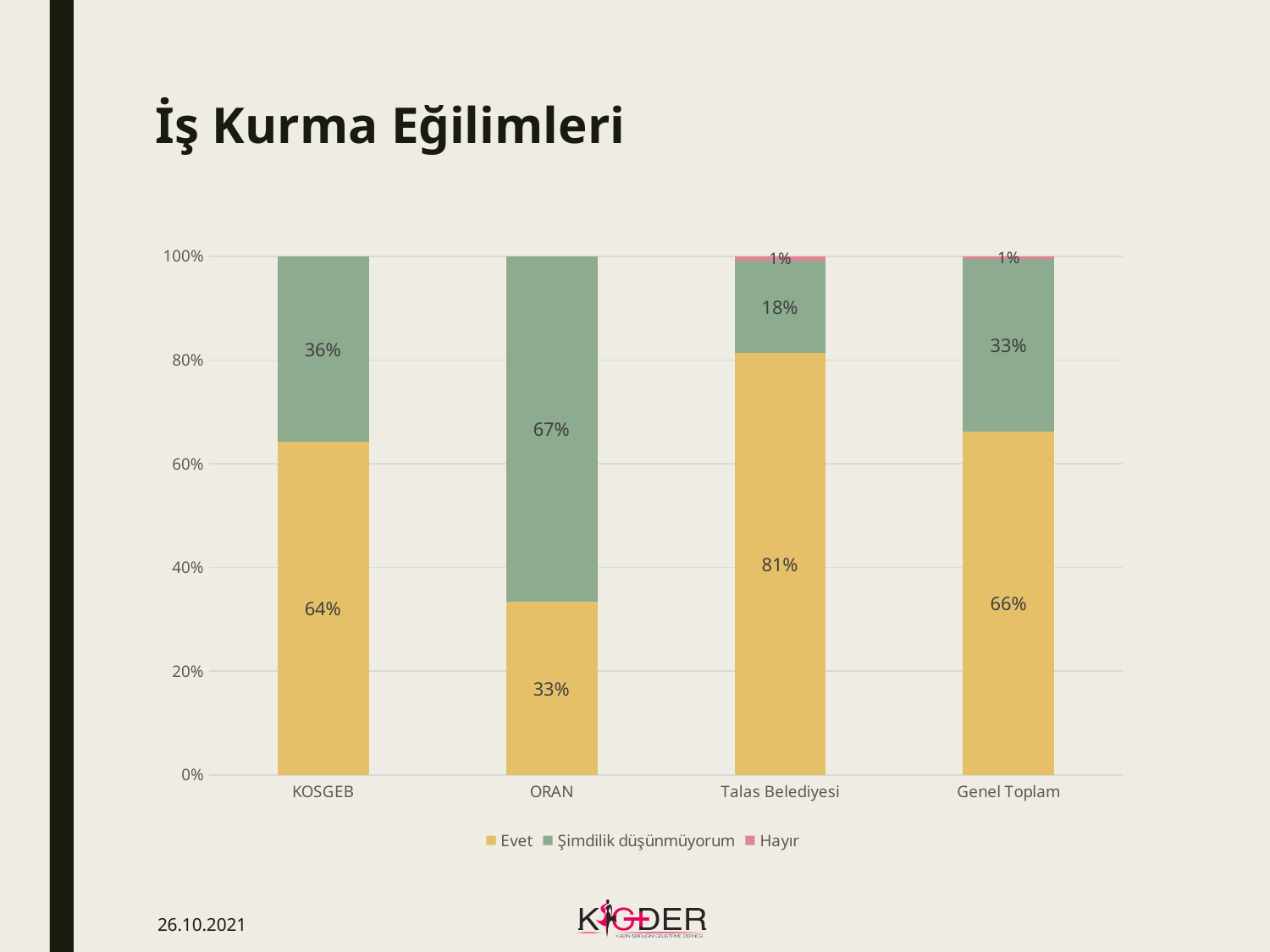
What kind of chart is shown on the slide? Stacked bar chart How many series does the legend list? 3 What is the Şimdilik düşünmüyorum value for ORAN? 67% Which is larger: the Şimdilik düşünmüyorum value for KOSGEB or for Talas Belediyesi? KOSGEB How many categories are shown on the x axis? 4 What is the Hayır value for Genel Toplam? 1% Which category has the highest Evet value? Talas Belediyesi What is the Evet value for Talas Belediyesi? 81% What is the Evet value for KOSGEB? 64% Which category has the lowest Evet value? ORAN What is the difference between the Evet values for Talas Belediyesi and ORAN? 48% What is the title of the slide? İş Kurma Eğilimleri